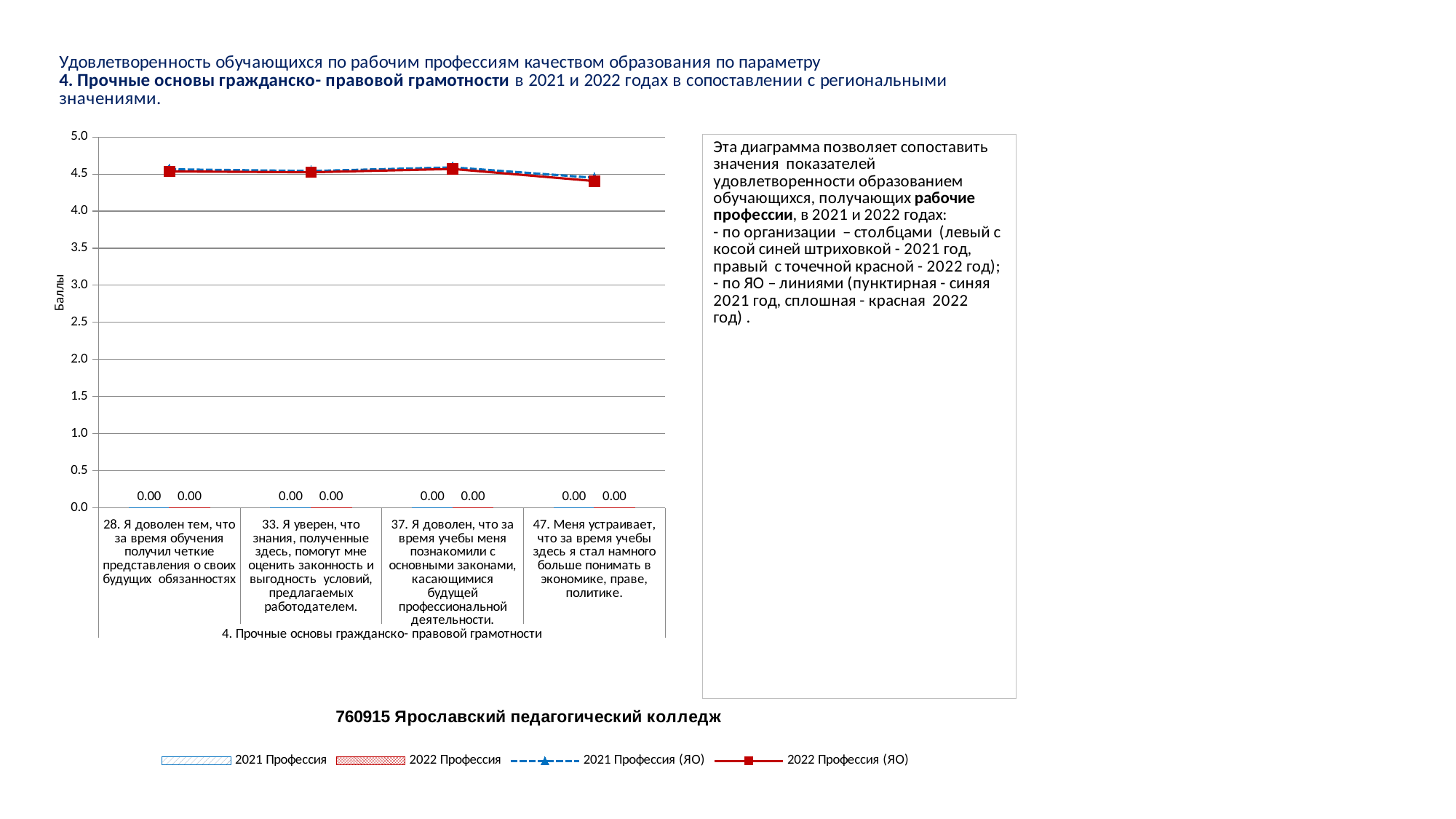
Does the 2022 Профессия (ЯО) line rise or fall between category 37 and category 47? fall How many series does the chart legend list? 4 How many categories (questions) are shown along the x axis of the chart? 4 What is the title printed below the chart? 760915 Ярославский педагогический колледж What is the data label shown for the 2021 Профессия bar in category 28 (Я доволен тем, что за время обучения получил четкие представления о своих будущих обязанностях)? 0.00 What is the data label shown for the 2022 Профессия bar in category 47 (Меня устраивает, что за время учебы здесь я стал намного больше понимать в экономике, праве, политике)? 0.00 What is the maximum value shown on the vertical axis of the chart? 5.0 Which category has the lowest value on the 2022 Профессия (ЯО) line? 47. Меня устраивает, что за время учебы здесь я стал намного больше понимать в экономике, праве, политике. What is the label of the vertical axis of the chart? Баллы Is the 2022 Профессия (ЯО) line value for category 33 greater or less than 4.0? greater Is the 2021 Профессия (ЯО) line value for category 47 greater or less than 5.0? less Is the 2022 Профессия (ЯО) line value for category 28 greater or less than 3.5? greater